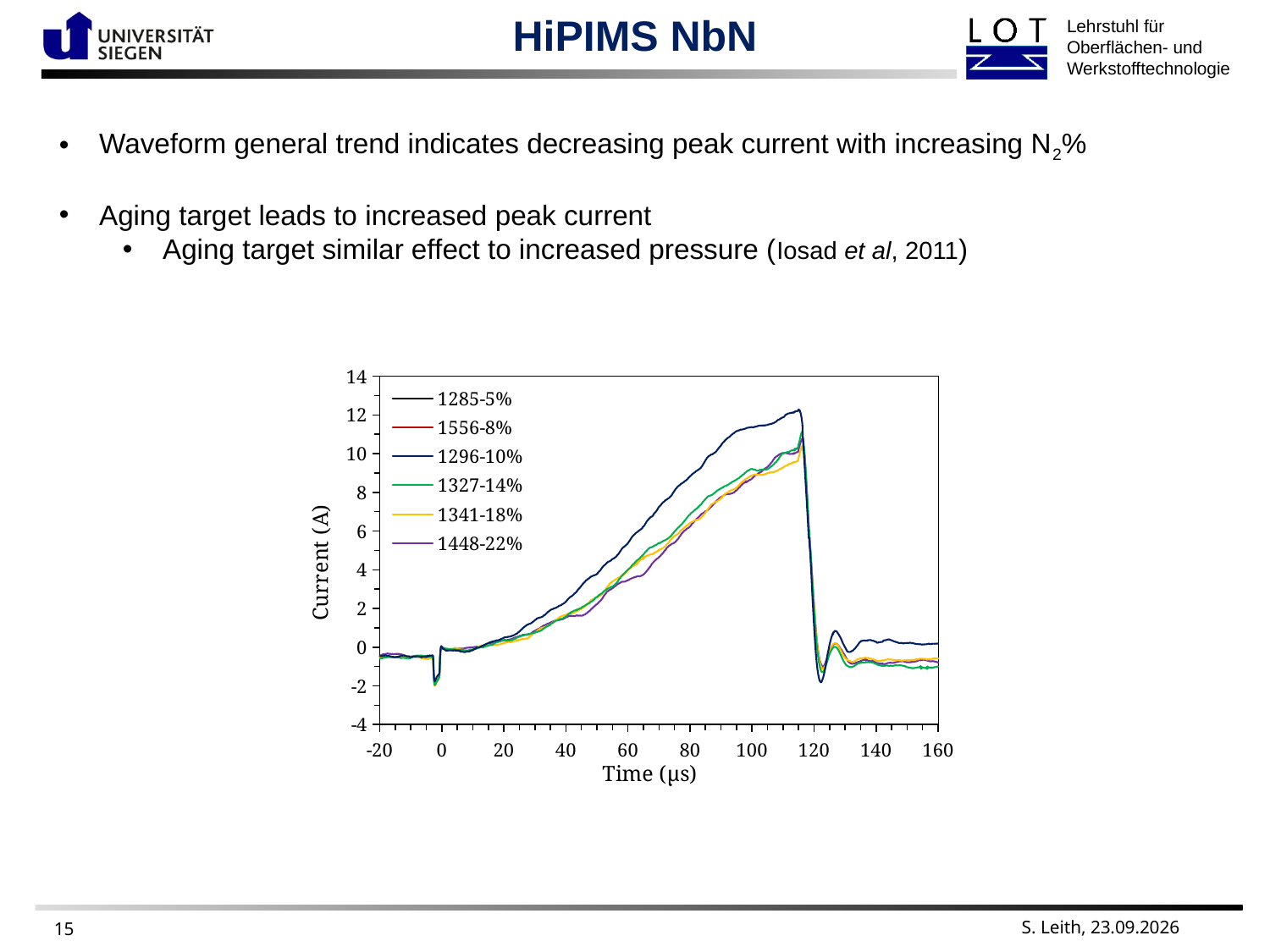
How many series does the chart legend list? 6 Immediately after the sharp drop at about 120 µs, is the current greater or less than 0 A? less Is the peak current of the 1341-18% series greater or less than 8 A? greater Is the current of the 1327-14% series at 40 µs greater or less than 4 A? less What is the label of the y axis of the chart? Current (A) Between 0 µs and about 110 µs, does the current rise or fall along the x axis? rise What is the label of the x axis of the chart? Time (µs) What is the maximum value shown on the y axis of the chart? 14 What kind of chart is shown on the slide? line chart